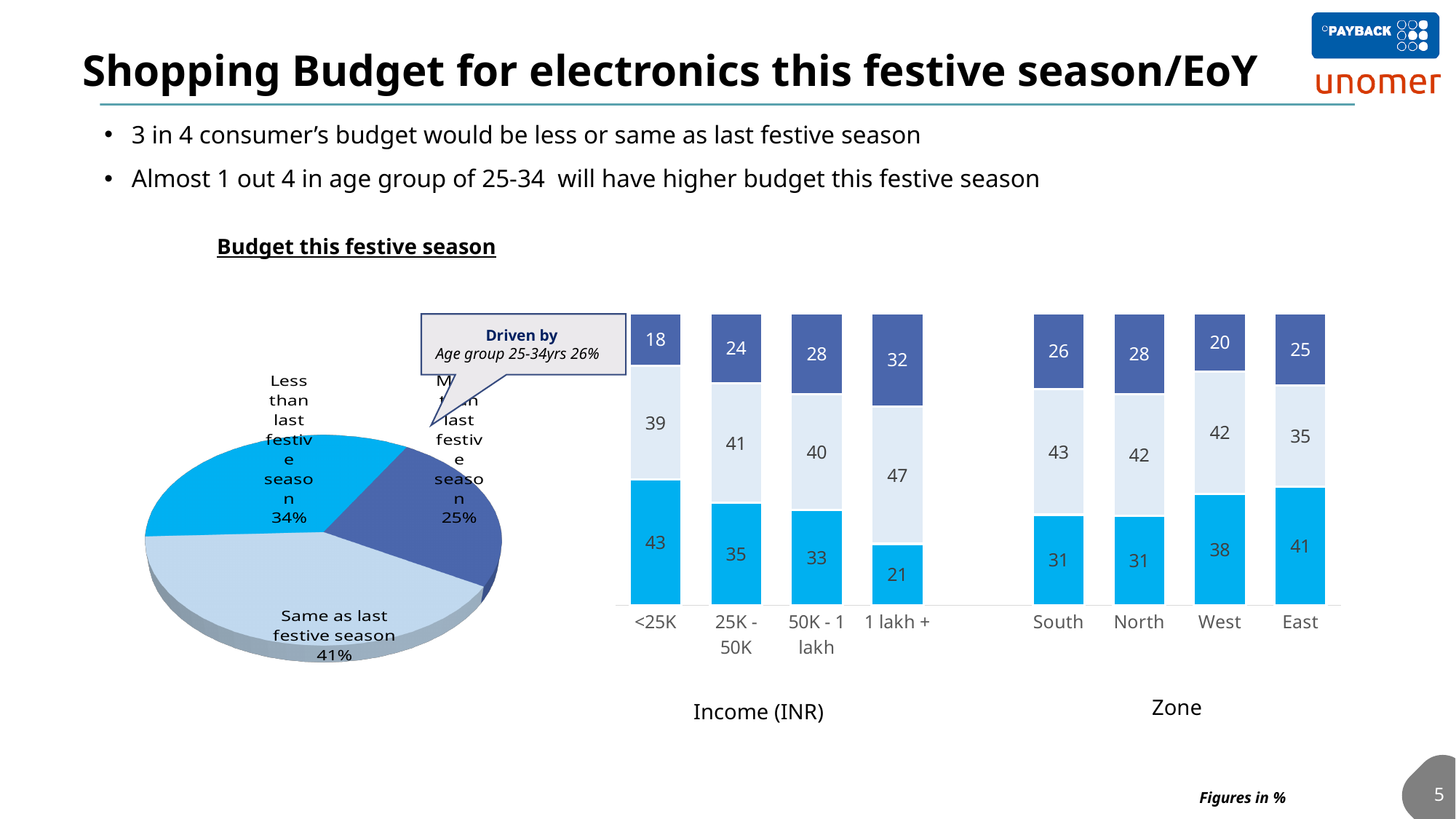
In the stacked bar chart, is the bottom (bright blue) segment value larger for West or for North? West In the pie chart 'Budget this festive season', what share of consumers say their budget is the same as last festive season? 41% What type of chart is used to show the Income (INR) and Zone breakdowns? Stacked bar chart In the stacked bar chart, which income group has the highest value in the top (dark blue) segment? 1 lakh + In the stacked bar chart, what is the value of the top (dark blue) segment for the 1 lakh + income group? 32 In the stacked bar chart, what is the value of the middle (light) segment for the West zone? 42 How many slices does the pie chart 'Budget this festive season' have? 3 In the pie chart 'Budget this festive season', which slice is the smallest? More than last festive season In the stacked bar chart, what is the value of the bottom (bright blue) segment for the <25K income group? 43 In the pie chart 'Budget this festive season', which slice is the largest? Same as last festive season In the pie chart 'Budget this festive season', what share of consumers say their budget is less than last festive season? 34% In the stacked bar chart, what is the difference between the bottom (bright blue) segment values for East and South? 10